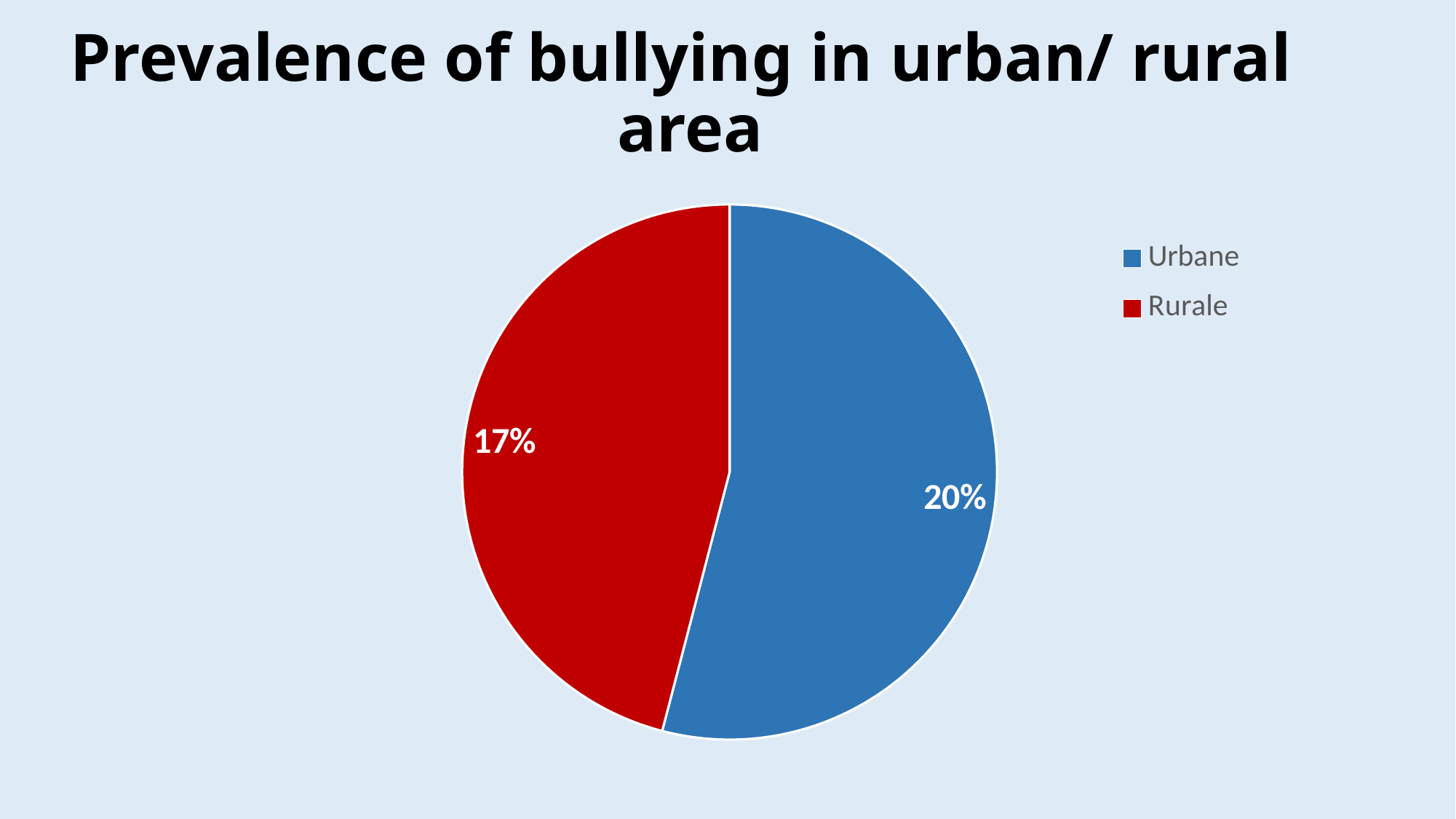
How many entries does the legend list? 2 Is the value for Urbane larger or smaller than the value for Rurale? larger What value is shown for the Rurale slice? 17% What kind of chart is shown on the slide? pie chart What value is shown for the Urbane slice? 20% How many slices does the pie chart have? 2 Which category has the larger slice? Urbane What colour is the Rurale slice? red What is the title of the slide? Prevalence of bullying in urban/ rural area Which category has the smaller slice? Rurale What is the difference between the Urbane and Rurale values? 3%